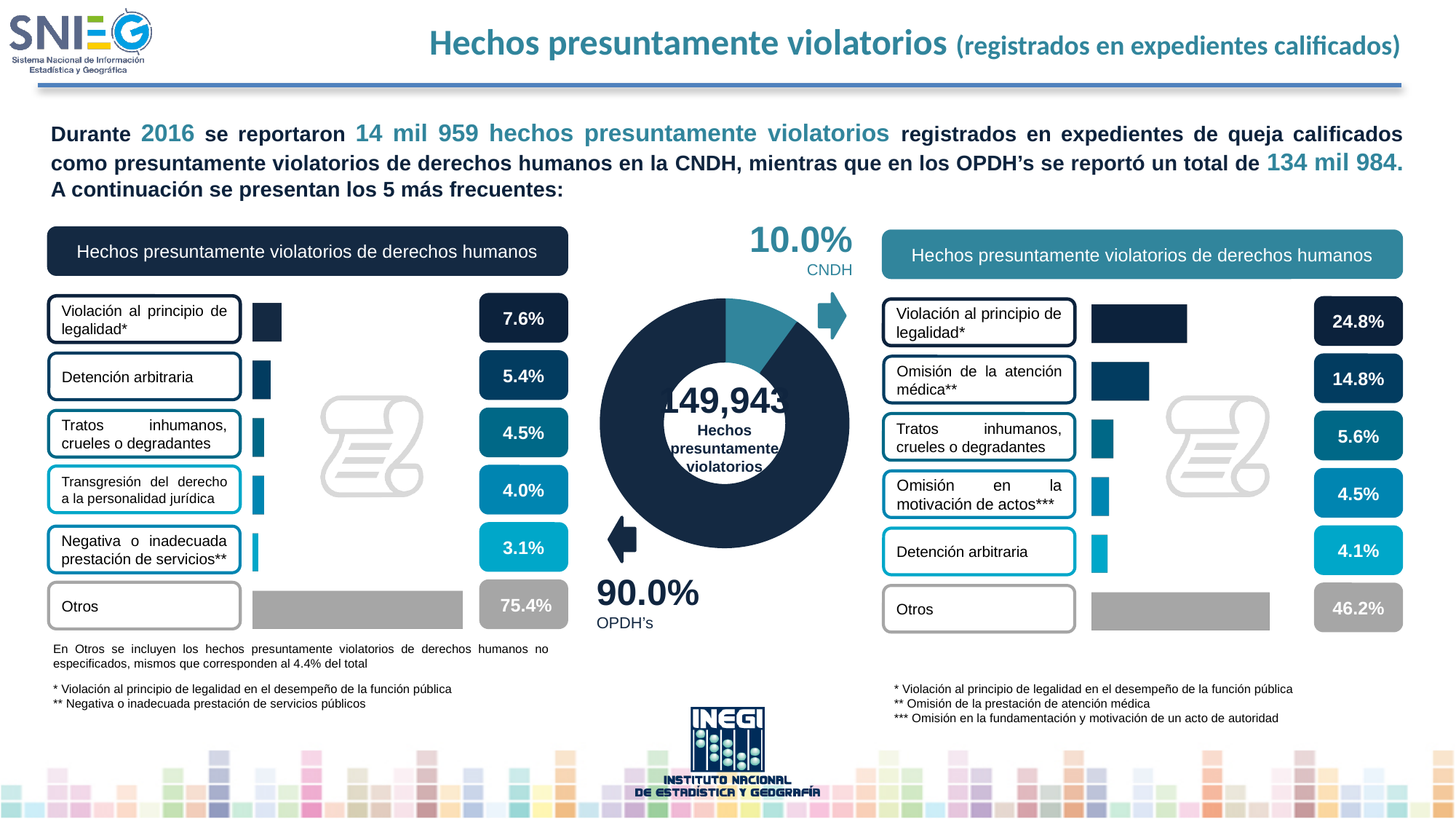
How many categories, including Otros, are shown in the left bar chart? 6 In the right bar chart, what is the value for Omisión de la atención médica? 14.8% In the left bar chart, what is the value for Detención arbitraria? 5.4% In the right bar chart, which category has the highest value? Otros In the right bar chart, what is the value for Otros? 46.2% In the center donut chart, what share does OPDH's represent? 90.0% In the left bar chart, which of the five named categories (excluding Otros) has the lowest value? Negativa o inadecuada prestación de servicios In the center donut chart, what share does CNDH represent? 10.0% In the left bar chart, what is the value for Violación al principio de legalidad? 7.6% What total number is shown in the center of the donut chart? 149,943 In the right bar chart, what is the difference between Violación al principio de legalidad and Omisión de la atención médica? 10.0% Which is larger: Detención arbitraria in the left bar chart or Detención arbitraria in the right bar chart? Left bar chart (5.4%)